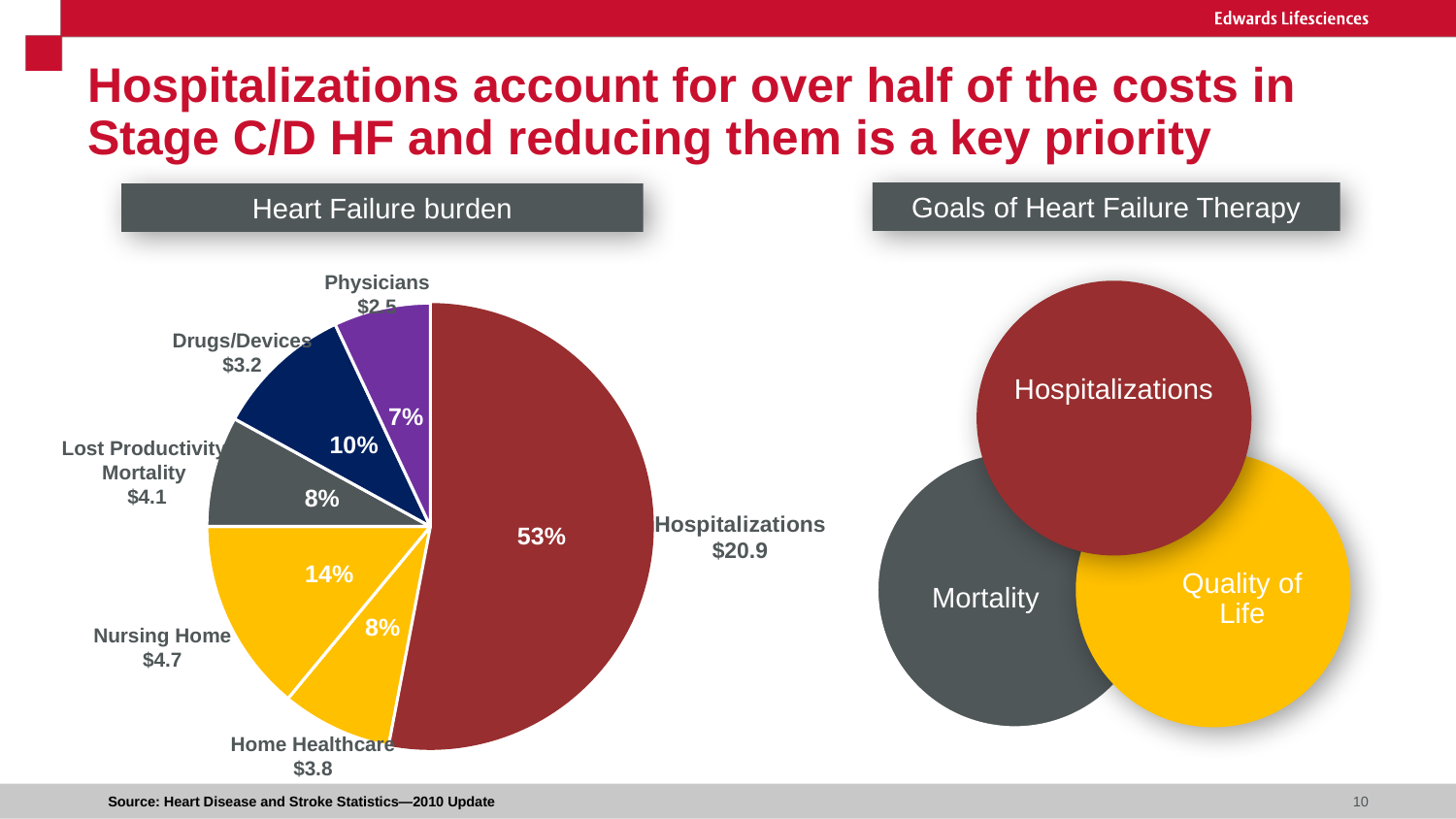
In the Heart Failure burden pie chart, which has a larger dollar value, Lost Productivity Mortality or Drugs/Devices? Lost Productivity Mortality What is the dollar value shown for Hospitalizations in the Heart Failure burden pie chart? $20.9 What type of chart is shown under "Heart Failure burden"? pie chart Which category has the largest slice in the Heart Failure burden pie chart? Hospitalizations What is the dollar value shown for Home Healthcare in the Heart Failure burden pie chart? $3.8 What share of the Heart Failure burden pie does Physicians represent? 7% What is the dollar value shown for Drugs/Devices in the Heart Failure burden pie chart? $3.2 In the Heart Failure burden pie chart, what is the difference in dollar value between Hospitalizations and Nursing Home? $16.2 How many categories are shown in the Heart Failure burden pie chart? 6 What share of the Heart Failure burden pie does Hospitalizations represent? 53% Which category has the smallest slice in the Heart Failure burden pie chart? Physicians What is the dollar value shown for Nursing Home in the Heart Failure burden pie chart? $4.7